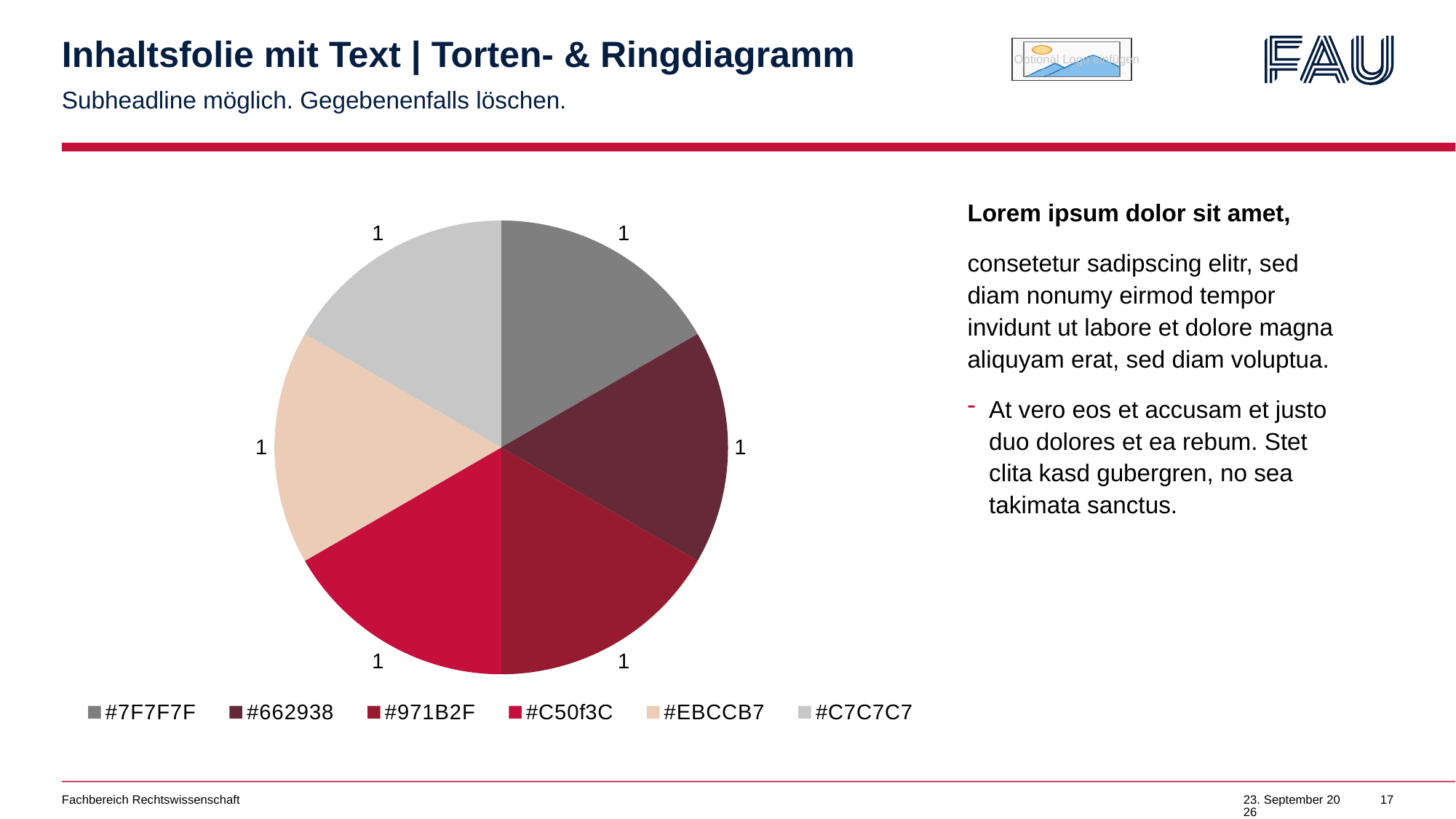
What is the total of all slice values in the pie chart? 6 What share of the pie does the #C7C7C7 slice represent? 1/6 Which legend entry is shown in the lightest beige colour? #EBCCB7 What is the difference between the values of the #971B2F and #C7C7C7 slices? 0 What is the value of the #662938 slice in the pie chart? 1 What is the value of the #EBCCB7 slice in the pie chart? 1 Which legend entry appears first (leftmost) in the legend? #7F7F7F How many entries does the legend of the pie chart list? 6 How many slices does the pie chart have? 6 What is the value of the #C50f3C slice in the pie chart? 1 What is the value of the #7F7F7F slice in the pie chart? 1 What kind of chart is shown on the slide? pie chart